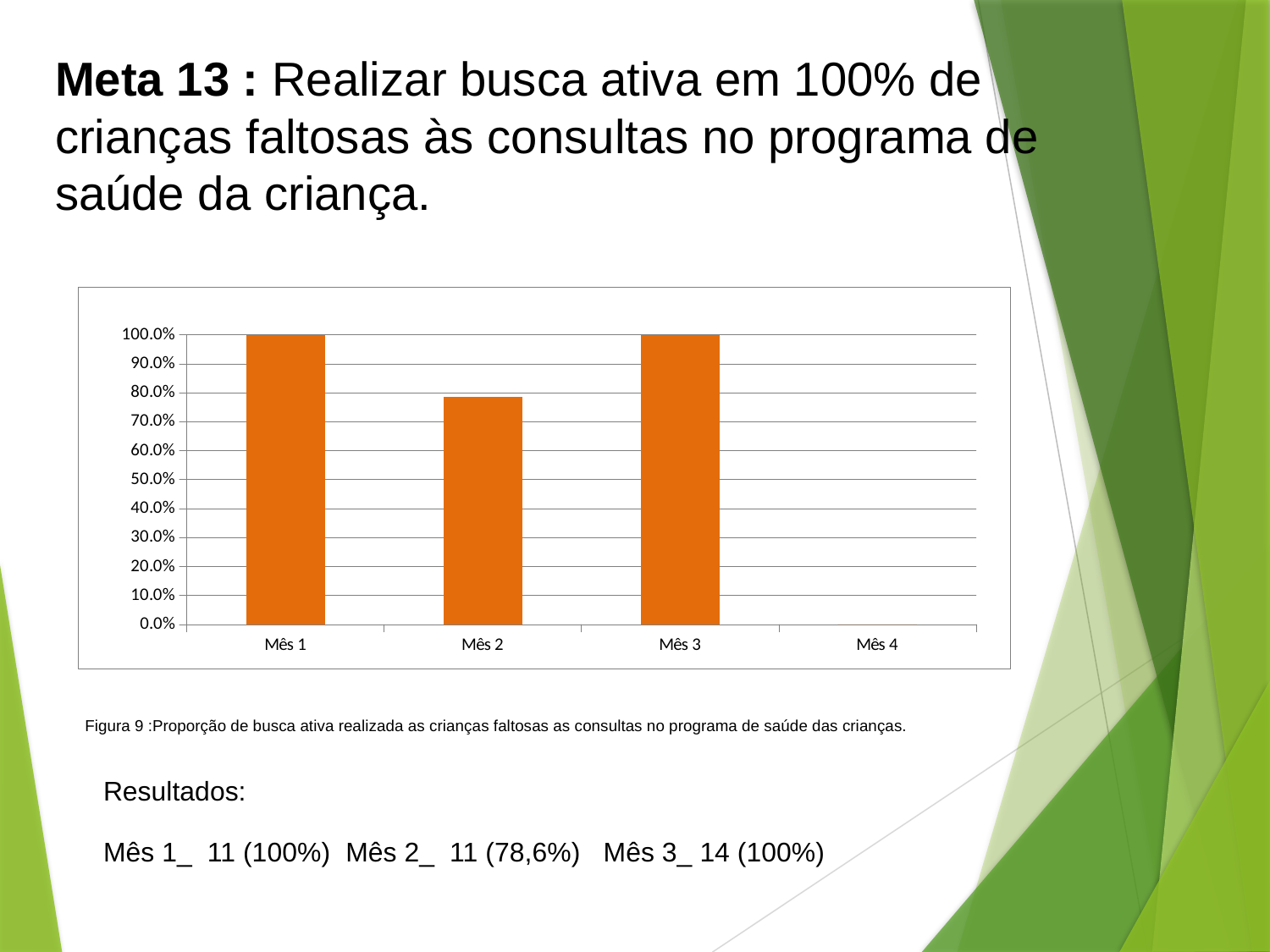
Which of Mês 2 and Mês 3 has the larger value? Mês 3 What is the value for Mês 3? 100.0% What kind of chart is shown on the slide? bar chart Is the value for Mês 2 greater or less than 70.0%? greater Is the value for Mês 2 greater or less than 80.0%? less How many categories are shown on the x axis? 4 What colour are the bars in the chart? orange What is the value for Mês 1? 100.0% Which category on the x axis has no bar? Mês 4 Which of Mês 1 and Mês 2 has the larger value? Mês 1 How many bars are plotted in the chart? 3 Among the months with a bar, which has the lowest value? Mês 2